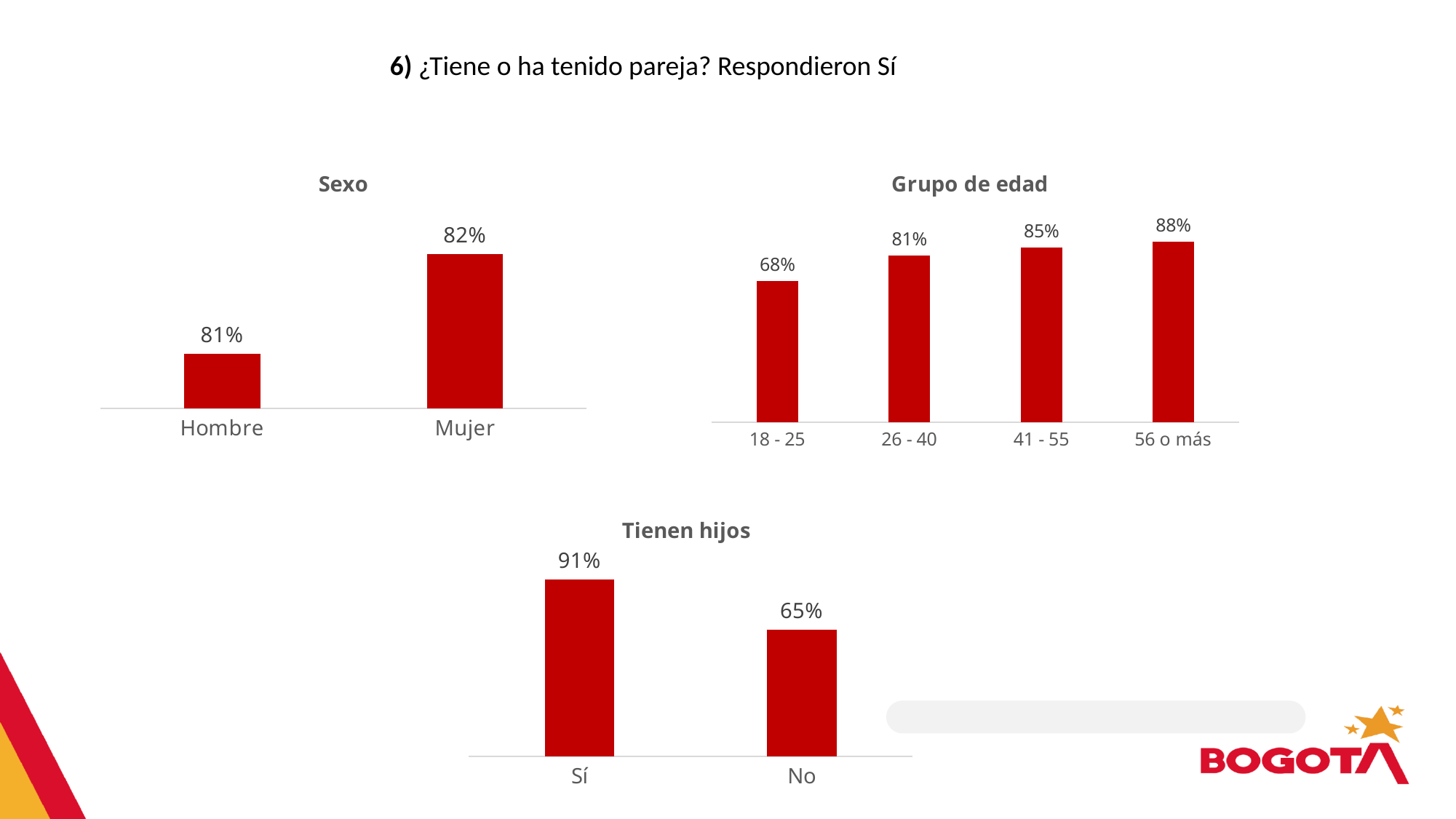
In the 'Sexo' chart, what is the value for Hombre? 81% What kind of chart is the 'Sexo' chart? bar chart In the 'Tienen hijos' chart, which is larger, Sí or No? Sí In the 'Grupo de edad' chart, which age group has the highest value? 56 o más In the 'Sexo' chart, what is the value for Mujer? 82% In the 'Grupo de edad' chart, what is the difference between the 56 o más group and the 18 - 25 group? 20% In the 'Grupo de edad' chart, how many age groups are shown? 4 In the 'Grupo de edad' chart, which age group has the lowest value? 18 - 25 In the 'Grupo de edad' chart, do the values rise or fall from 18 - 25 to 56 o más? rise In the 'Tienen hijos' chart, what is the difference between Sí and No? 26% In the 'Grupo de edad' chart, what is the value for the 18 - 25 group? 68% In the 'Tienen hijos' chart, what is the value for Sí? 91%